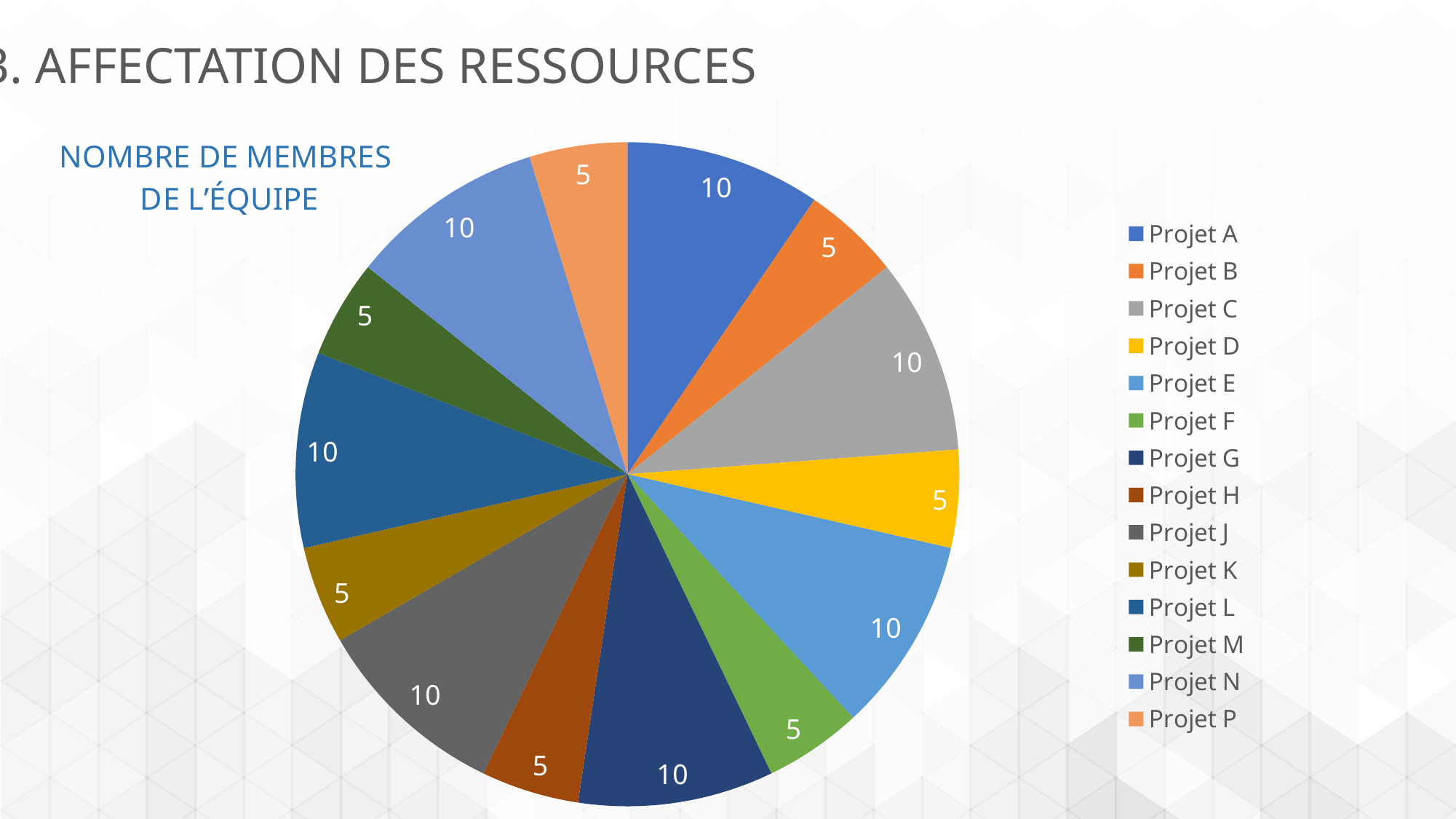
What is the value for Projet B? 5 What is the difference between the values for Projet C and Projet H? 5 What kind of chart is shown on the slide? pie chart How many slices does the pie chart have? 14 What is the value for Projet D? 5 Which is larger, the value for Projet E or the value for Projet F? Projet E What is the value for Projet N? 10 Which is larger, the value for Projet K or the value for Projet L? Projet L What is the value for Projet A? 10 How many entries does the legend list? 14 What is the value for Projet G? 10 What is the title of the chart? NOMBRE DE MEMBRES DE L'ÉQUIPE